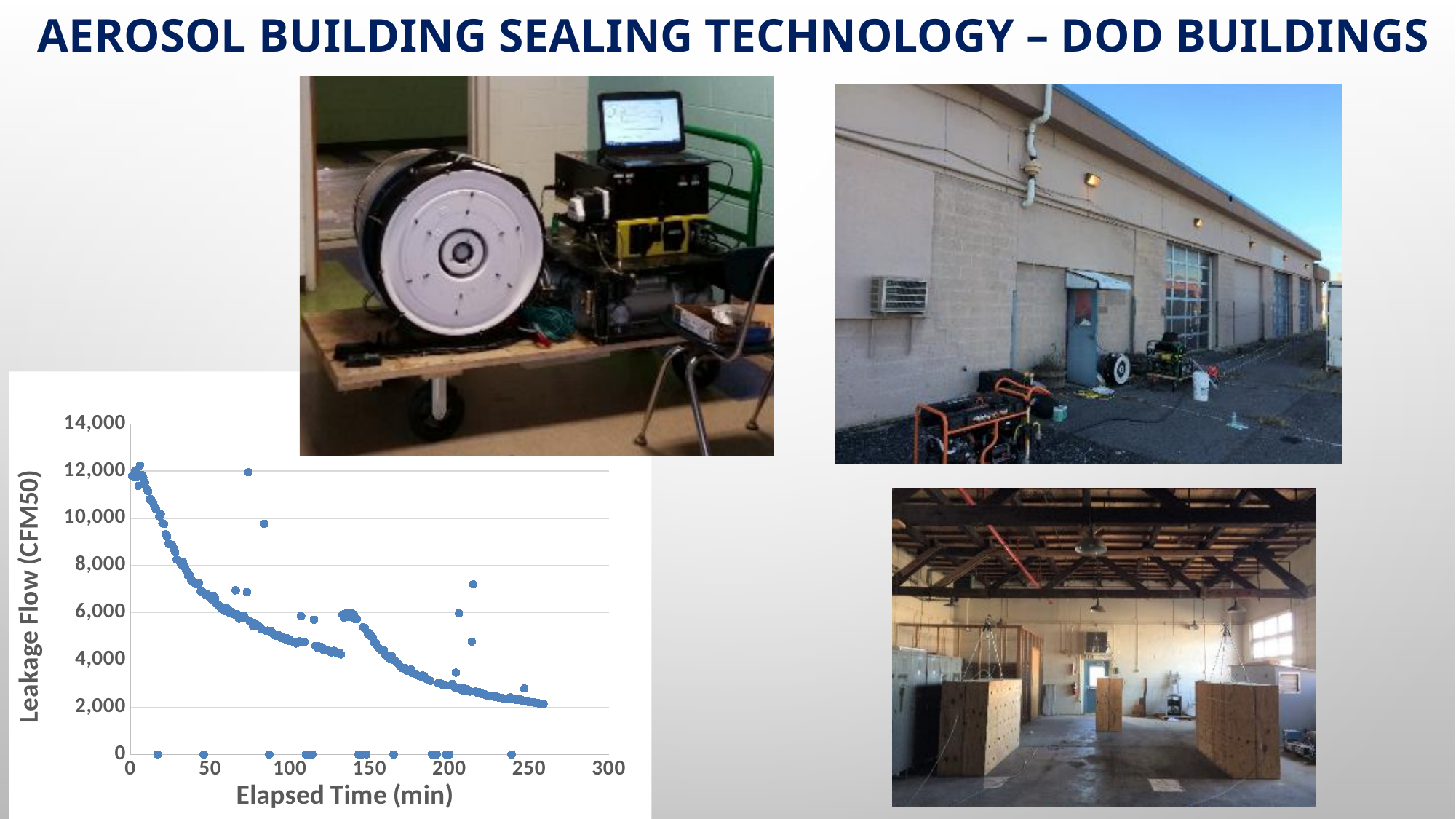
Do the leakage flow values generally rise or fall as elapsed time increases? fall Is the leakage flow at about 250 min greater or less than 4,000? less Is the leakage flow at about 50 min greater or less than 6,000? greater What is the label of the vertical axis of the chart? Leakage Flow (CFM50) Is the leakage flow at about 100 min greater or less than 6,000? less Which is larger: the leakage flow at about 150 min or at about 25 min? at about 25 min What kind of chart is shown on the slide? scatter chart Which is larger: the leakage flow at about 10 min or at about 250 min? at about 10 min What is the label of the horizontal axis of the chart? Elapsed Time (min)